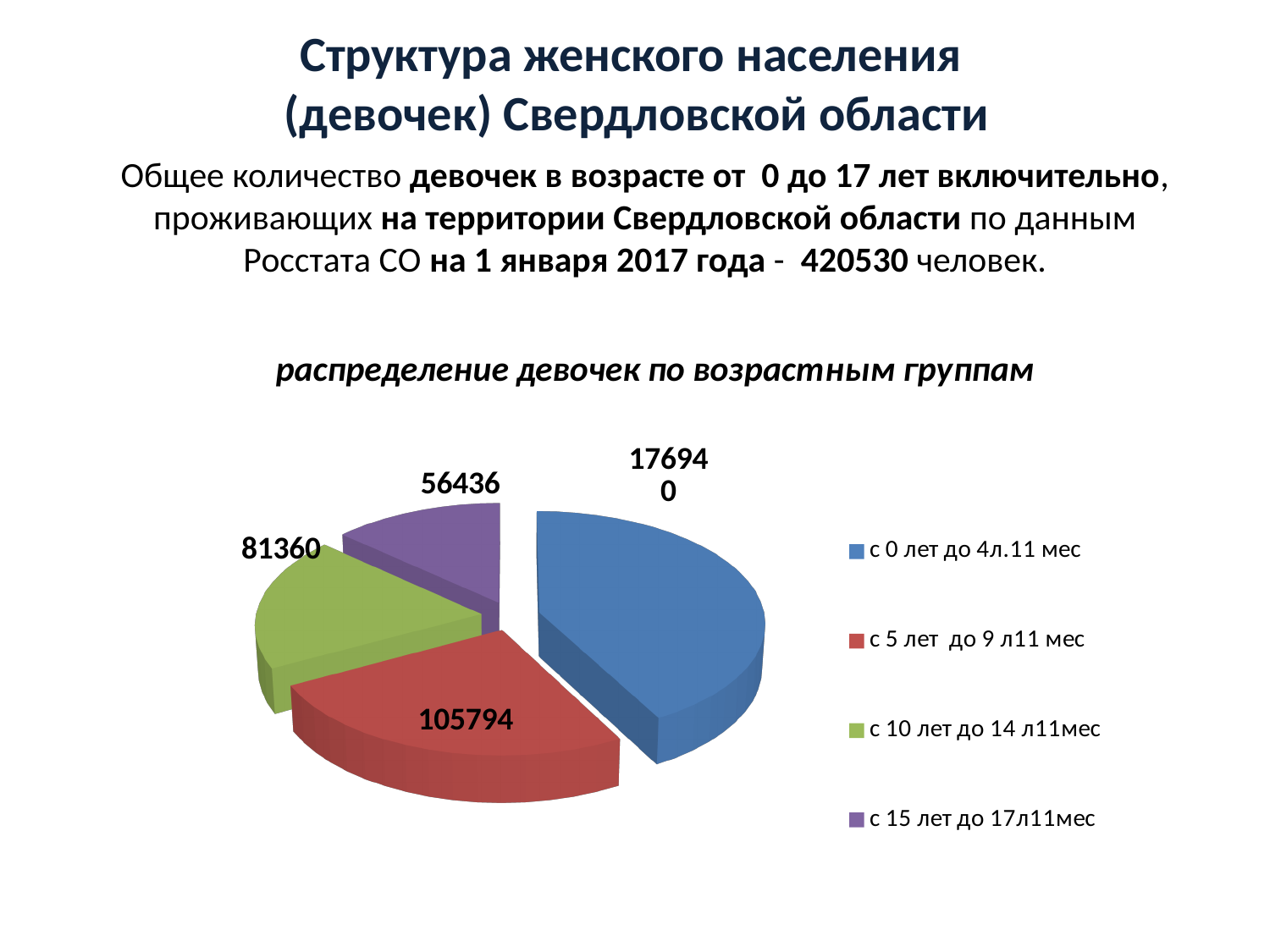
Which age group has the smallest slice of the pie? с 15 лет до 17л11мес How many age groups (slices) does the pie chart show? 4 What is the value for the group 'с 5 лет до 9 л11 мес'? 105794 What is the title of the chart? распределение девочек по возрастным группам Which age group has the largest slice of the pie? с 0 лет до 4л.11 мес Which is larger: the value for 'с 10 лет до 14 л11мес' or for 'с 15 лет до 17л11мес'? с 10 лет до 14 л11мес What type of chart is shown on the slide? pie chart What is the value for the group 'с 10 лет до 14 л11мес'? 81360 What is the difference between the values for 'с 0 лет до 4л.11 мес' and 'с 5 лет до 9 л11 мес'? 71146 What colour is the slice for 'с 5 лет до 9 л11 мес'? red What is the value for the group 'с 15 лет до 17л11мес'? 56436 What is the value for the group 'с 0 лет до 4л.11 мес'? 176940